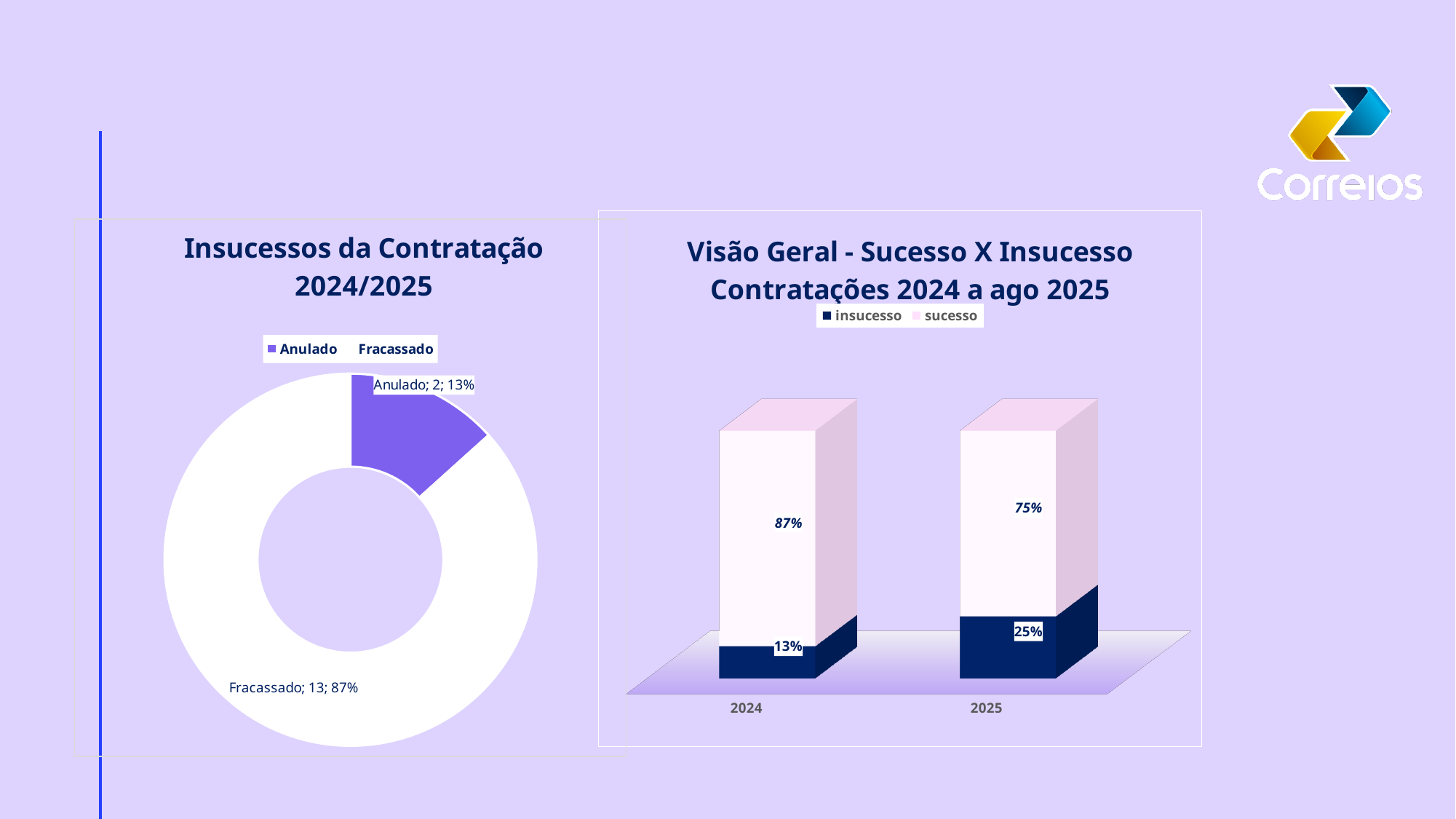
In the 'Insucessos da Contratação 2024/2025' chart, what is the value for Fracassado? 13 In the 'Visão Geral - Sucesso X Insucesso' chart, what is the value for insucesso in 2025? 25% In the 'Visão Geral - Sucesso X Insucesso' chart, what is the value for sucesso in 2024? 87% How many series does the legend of the 'Visão Geral - Sucesso X Insucesso' chart list? 2 In the 'Visão Geral - Sucesso X Insucesso' chart, what is the difference between the sucesso values for 2024 and 2025? 12% In the 'Insucessos da Contratação 2024/2025' chart, which category is the largest? Fracassado In the 'Visão Geral - Sucesso X Insucesso' chart, does the sucesso value rise or fall from 2024 to 2025? Fall In the 'Visão Geral - Sucesso X Insucesso' chart, which year has the higher insucesso value? 2025 In the 'Insucessos da Contratação 2024/2025' chart, what is the difference between Fracassado and Anulado? 11 What kind of chart is 'Insucessos da Contratação 2024/2025'? Pie chart (doughnut) In the 'Insucessos da Contratação 2024/2025' chart, what share of the pie does Fracassado represent? 87% In the 'Insucessos da Contratação 2024/2025' chart, what is the value for Anulado? 2